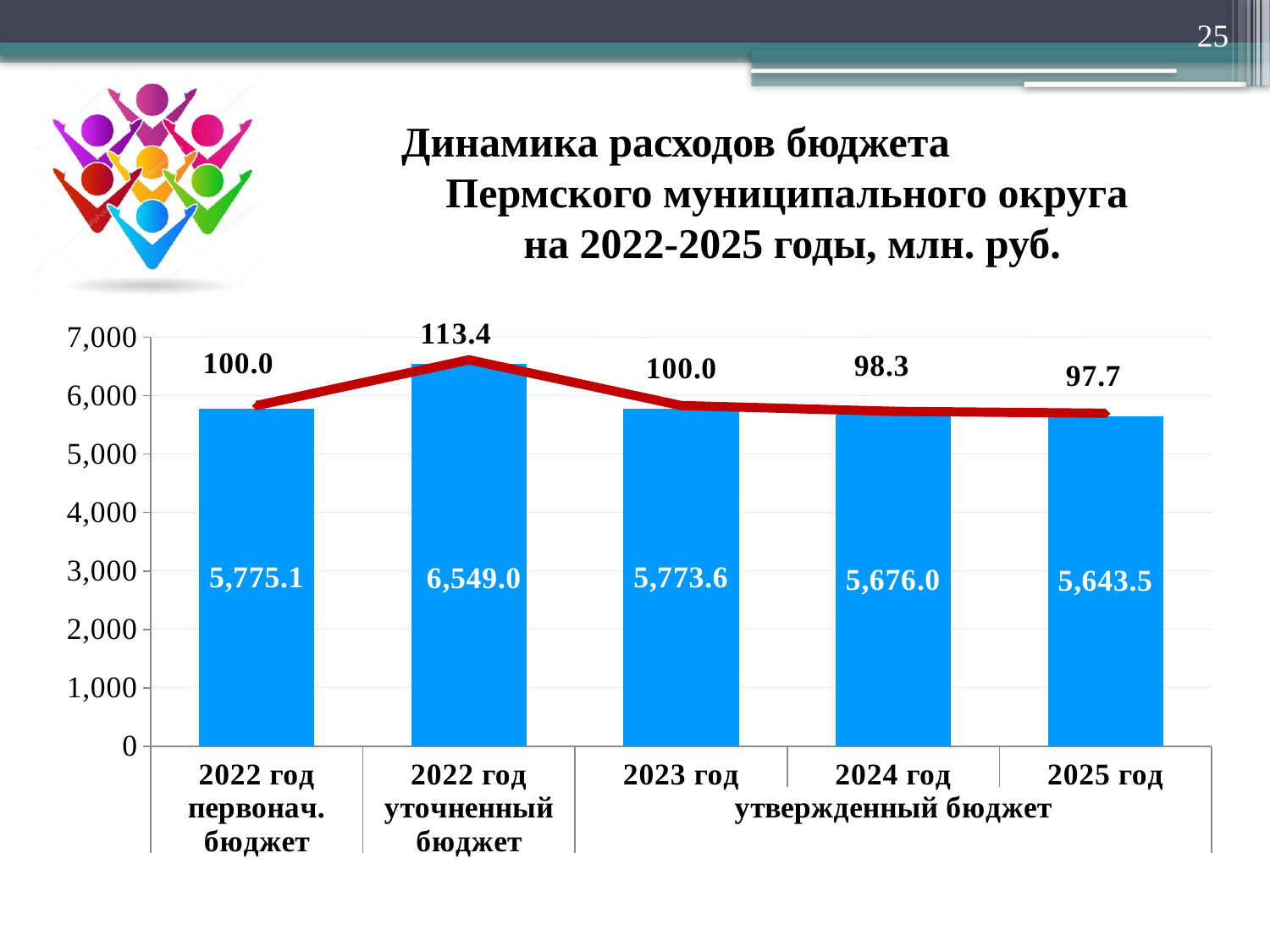
What is the budget expenditure value shown for 2023 год? 5,773.6 Is the bar value for 2022 год уточненный бюджет greater or less than 6,000? greater Which category has the highest bar? 2022 год уточненный бюджет Which is larger, the bar for 2024 год or the bar for 2025 год? 2024 год How many bars are plotted in the chart? 5 Do the bar values rise or fall from 2023 год to 2025 год? fall What is the difference between the bar values for 2022 год уточненный бюджет and 2022 год первонач. бюджет? 773.9 What value does the red line show for 2022 год уточненный бюджет? 113.4 Which category has the lowest bar? 2025 год What is the value of the bar for 2022 год уточненный бюджет? 6,549.0 What value does the red line show for 2024 год? 98.3 What is the difference between the bar values for 2024 год and 2025 год? 32.5